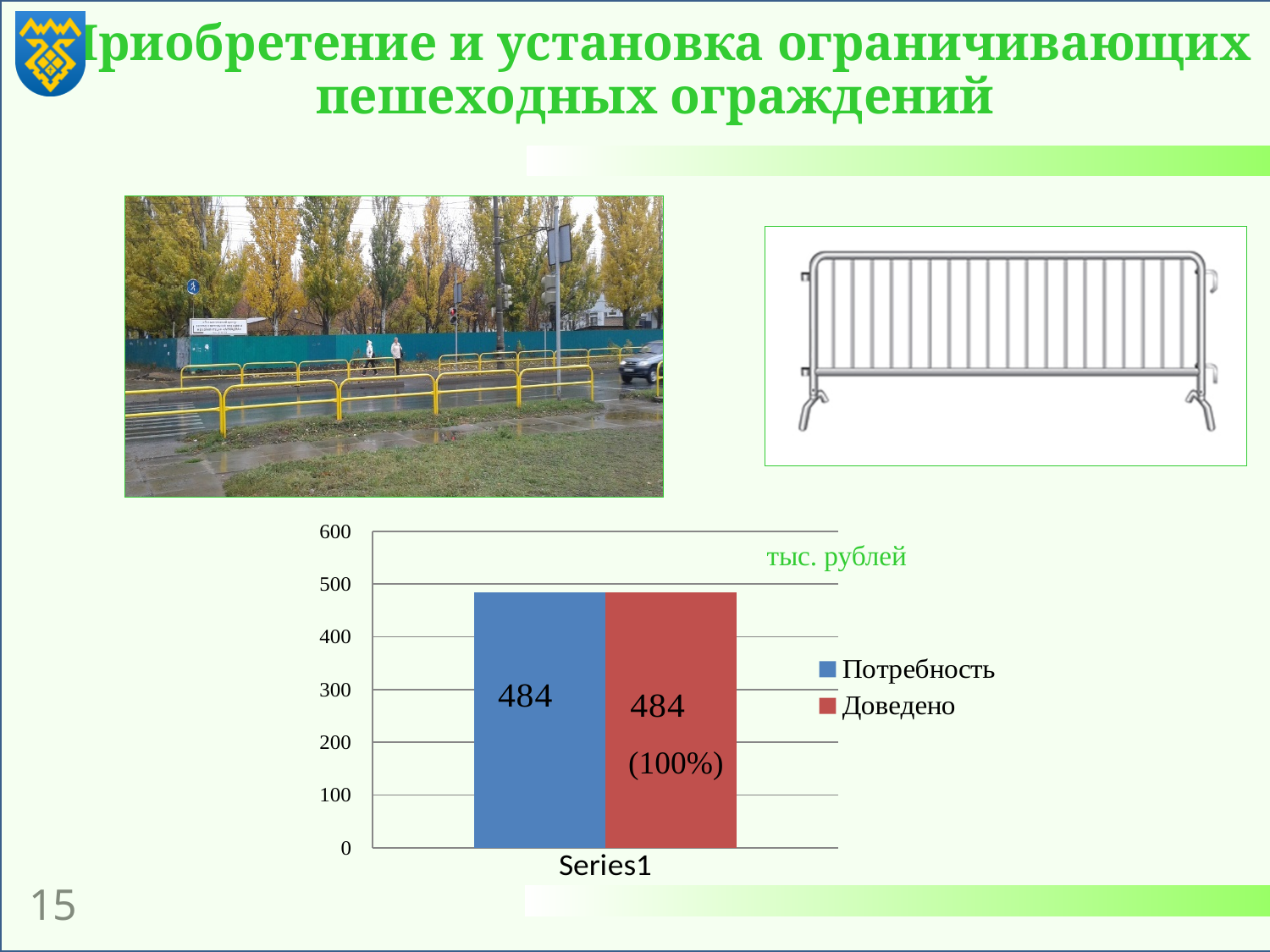
What category label is shown on the x axis of the chart? Series1 What kind of chart is shown on the slide? bar chart What percentage is printed on the Доведено bar? 100% What unit is indicated on the chart? тыс. рублей What is the difference between the Потребность and Доведено values? 0 What is the value of Потребность shown on the chart? 484 How many series does the legend list? 2 What is the highest value shown on the y axis of the chart? 600 How many bars are plotted on the chart? 2 What is the value of Доведено shown on the chart? 484 Is the value for Доведено greater or less than 500? less Is the value for Потребность greater or less than 400? greater